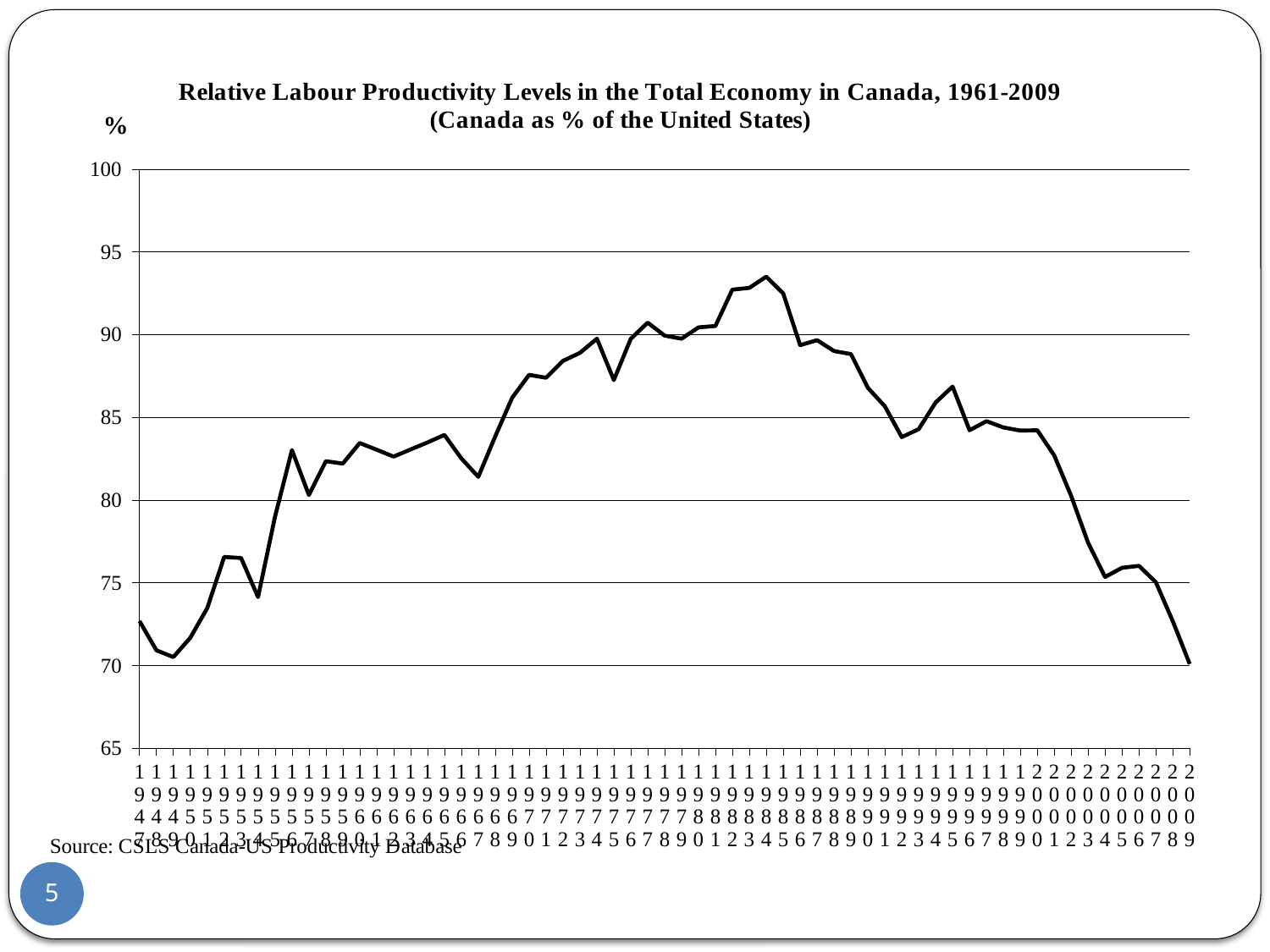
Is the value for 1965 greater or less than 80? greater Is the value for 1975 greater or less than 85? greater What is the title of the chart? Relative Labour Productivity Levels in the Total Economy in Canada, 1961-2009 (Canada as % of the United States) What kind of chart is shown on the slide? line chart Which is larger, the value for 1960 or the value for 2005? 1960 Do the values rise or fall between 1995 and 2009? fall What is the source cited below the chart? CSLS Canada-US Productivity Database Do the values rise or fall between 1949 and 1956? rise Is the value for 1949 greater or less than 75? less Which is larger, the value for 1950 or the value for 1970? 1970